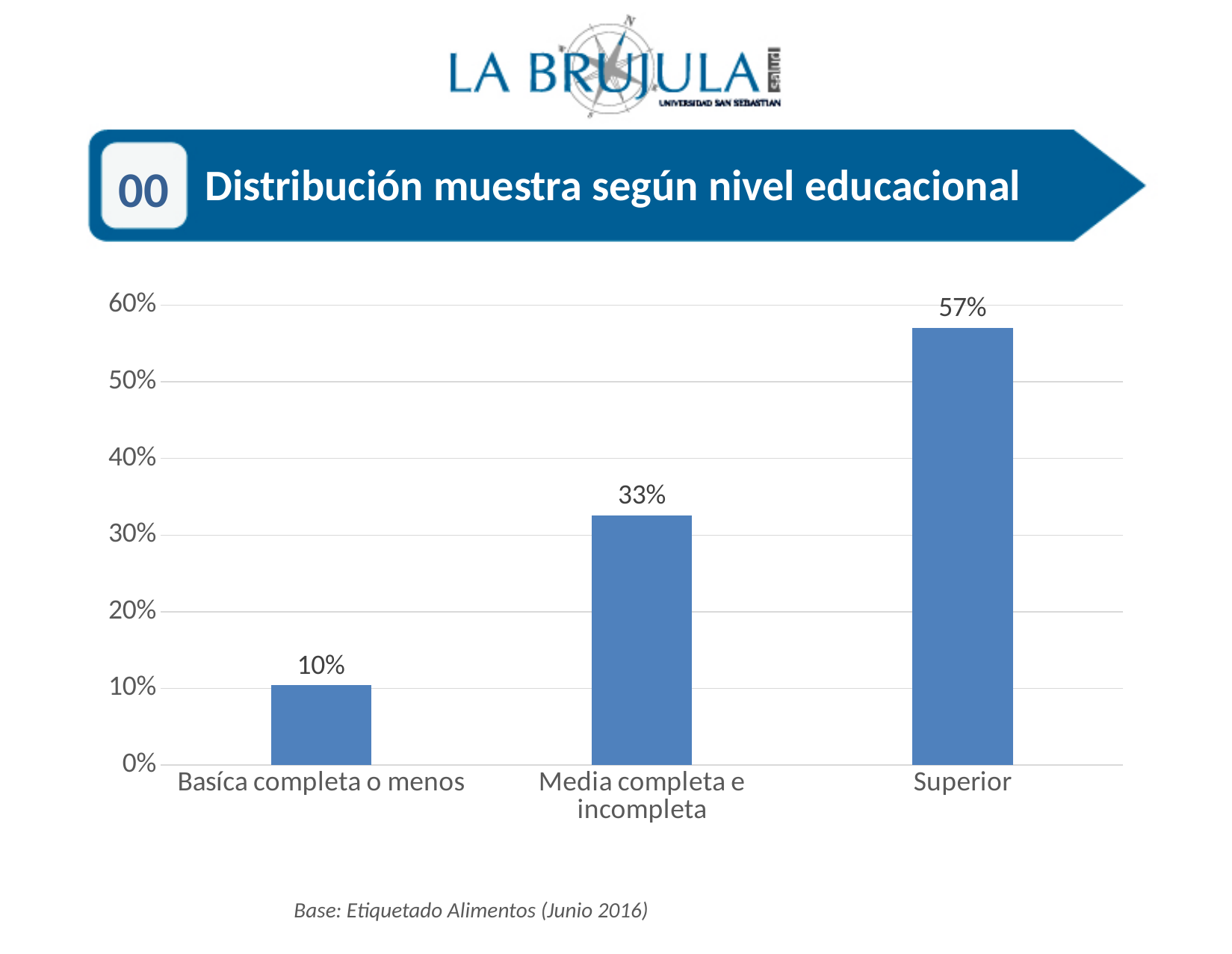
How many categories are shown in the chart? 3 What is the value for Media completa e incompleta? 33% Is the value for Superior greater or less than 50%? greater Which is larger, the value for Media completa e incompleta or the value for Basíca completa o menos? Media completa e incompleta What is the value for Superior? 57% Which category has the lowest value? Basíca completa o menos What is the difference between the values for Media completa e incompleta and Basíca completa o menos? 23% What is the title of the chart on the slide? Distribución muestra según nivel educacional Which category has the highest value? Superior What kind of chart is shown on the slide? bar chart What is the value for Basíca completa o menos? 10% What is the difference between the values for Superior and Media completa e incompleta? 24%